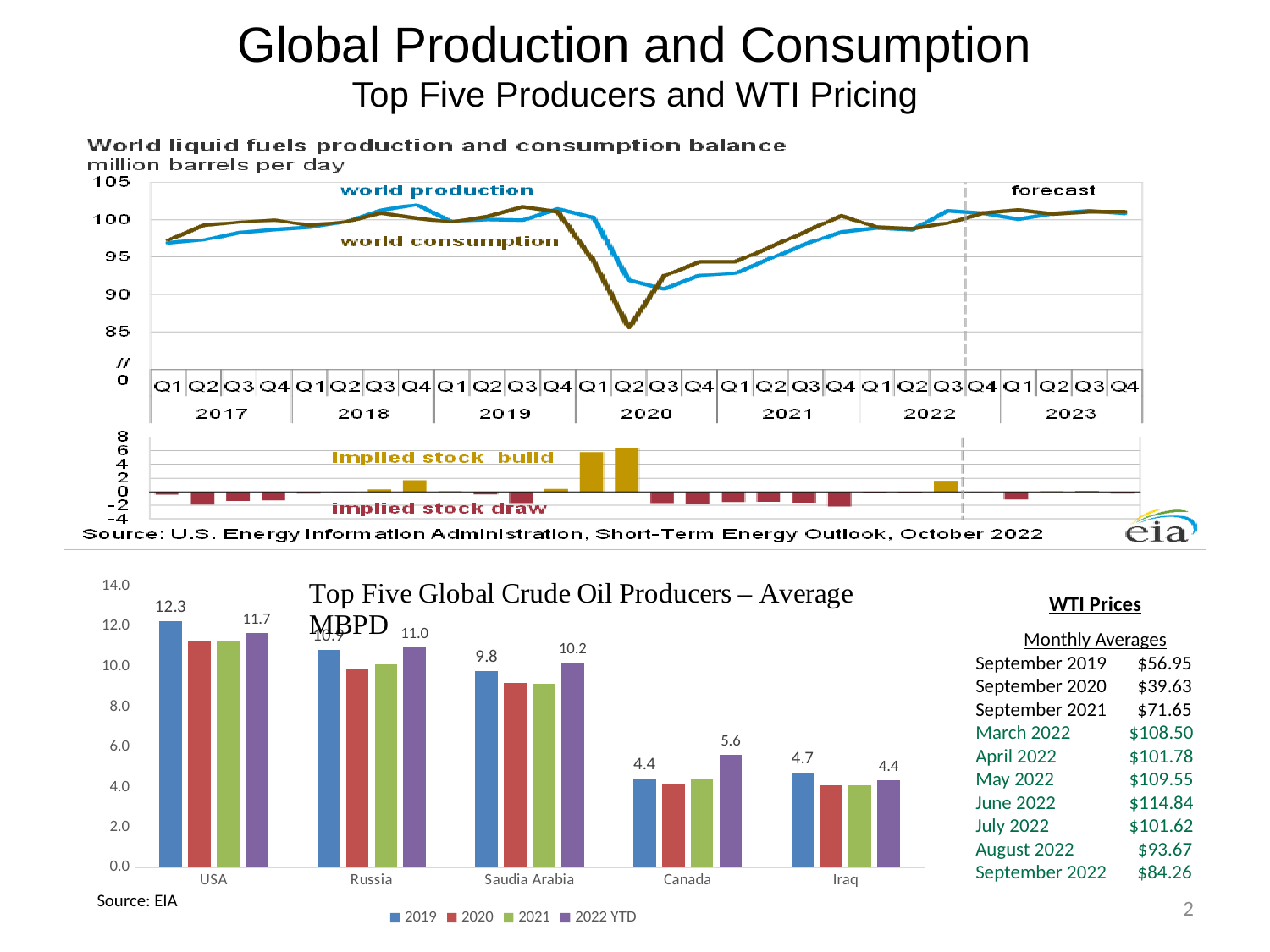
In the chart 'World liquid fuels production and consumption balance', is world consumption in Q2 2020 greater or less than 90 million barrels per day? less In the chart 'World liquid fuels production and consumption balance', is the implied stock build in Q2 2020 greater or less than 4? greater In the bar chart 'Top Five Global Crude Oil Producers – Average MBPD', which is larger: Canada's 2022 YTD value or Iraq's 2022 YTD value? Canada's 2022 YTD value How many countries are shown in the bar chart 'Top Five Global Crude Oil Producers – Average MBPD'? 5 In the bar chart 'Top Five Global Crude Oil Producers – Average MBPD', what is the difference between the USA's 2019 value and its 2022 YTD value? 0.6 What kind of chart is the 'World liquid fuels production and consumption balance' chart at the top of the slide? line chart In the bar chart 'Top Five Global Crude Oil Producers – Average MBPD', what is the 2019 value for Iraq? 4.7 In the bar chart 'Top Five Global Crude Oil Producers – Average MBPD', what is the 2022 YTD value for Canada? 5.6 In the bar chart 'Top Five Global Crude Oil Producers – Average MBPD', what is the 2019 value for the USA? 12.3 In the bar chart 'Top Five Global Crude Oil Producers – Average MBPD', what is the 2022 YTD value for Saudi Arabia? 10.2 In the bar chart 'Top Five Global Crude Oil Producers – Average MBPD', which country has the highest 2022 YTD value? USA How many series does the legend of the bar chart 'Top Five Global Crude Oil Producers – Average MBPD' list? 4